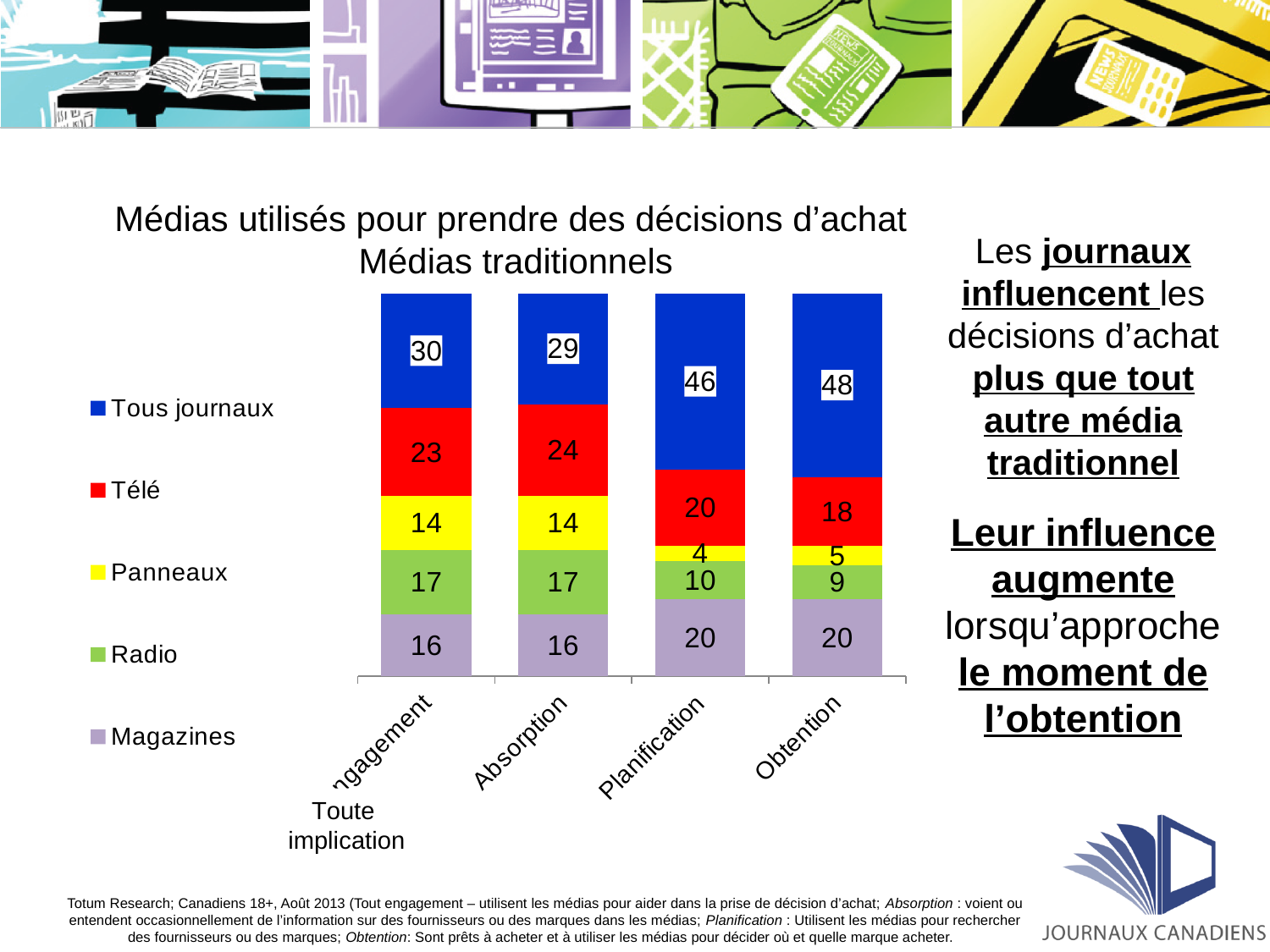
What is the value for Télé in the Absorption category? 24 How many series does the legend list? 5 What is the difference between the Tous journaux values for Obtention and Absorption? 19 What is the total of the stacked bar for Planification? 100 What is the value for Panneaux in the Planification category? 4 Which category has the lowest value for Radio? Obtention What kind of chart is shown? Stacked bar chart What is the value for Magazines in the Tout engagement category? 16 Which is larger, the Radio value for Absorption or for Obtention? Absorption What is the value for Tous journaux in the Obtention category? 48 Which category has the highest value for Tous journaux? Obtention How many categories are shown on the x axis? 4